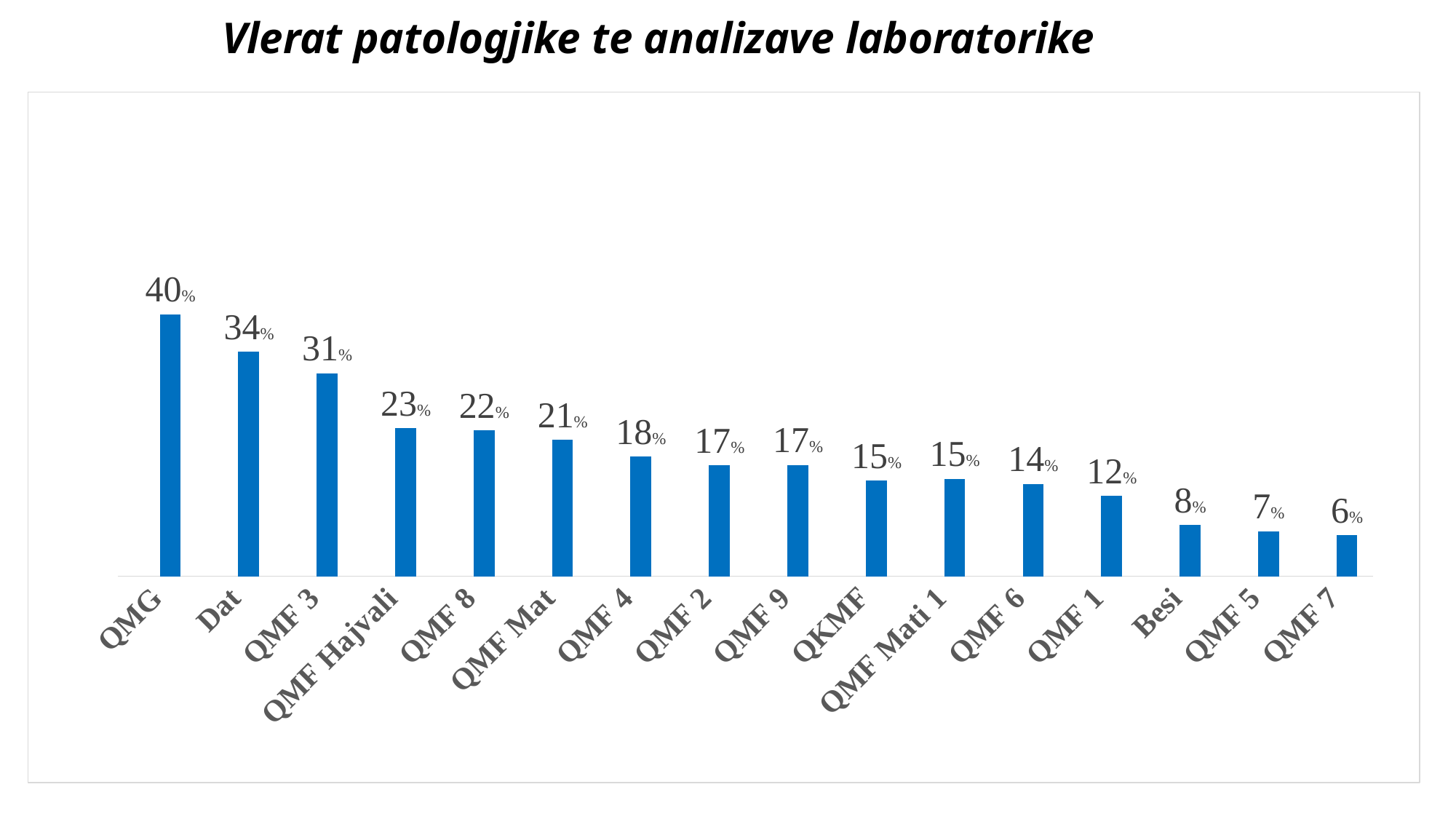
How many categories are shown on the x axis? 16 What is the difference between the values for QMF 3 and QMF 1? 19% Which category has the highest value? QMG What is the value for QMG? 40% What is the value for Besi? 8% What kind of chart is this? Bar chart What is the title of the chart? Vlerat patologjike te analizave laboratorike Which category has the lowest value? QMF 7 What is the difference between the values for QMG and Dat? 6% Which is larger, the value for QMF 8 or the value for QMF 4? QMF 8 Do the values rise or fall from left to right along the x axis? Fall What is the value for QMF Hajvali? 23%